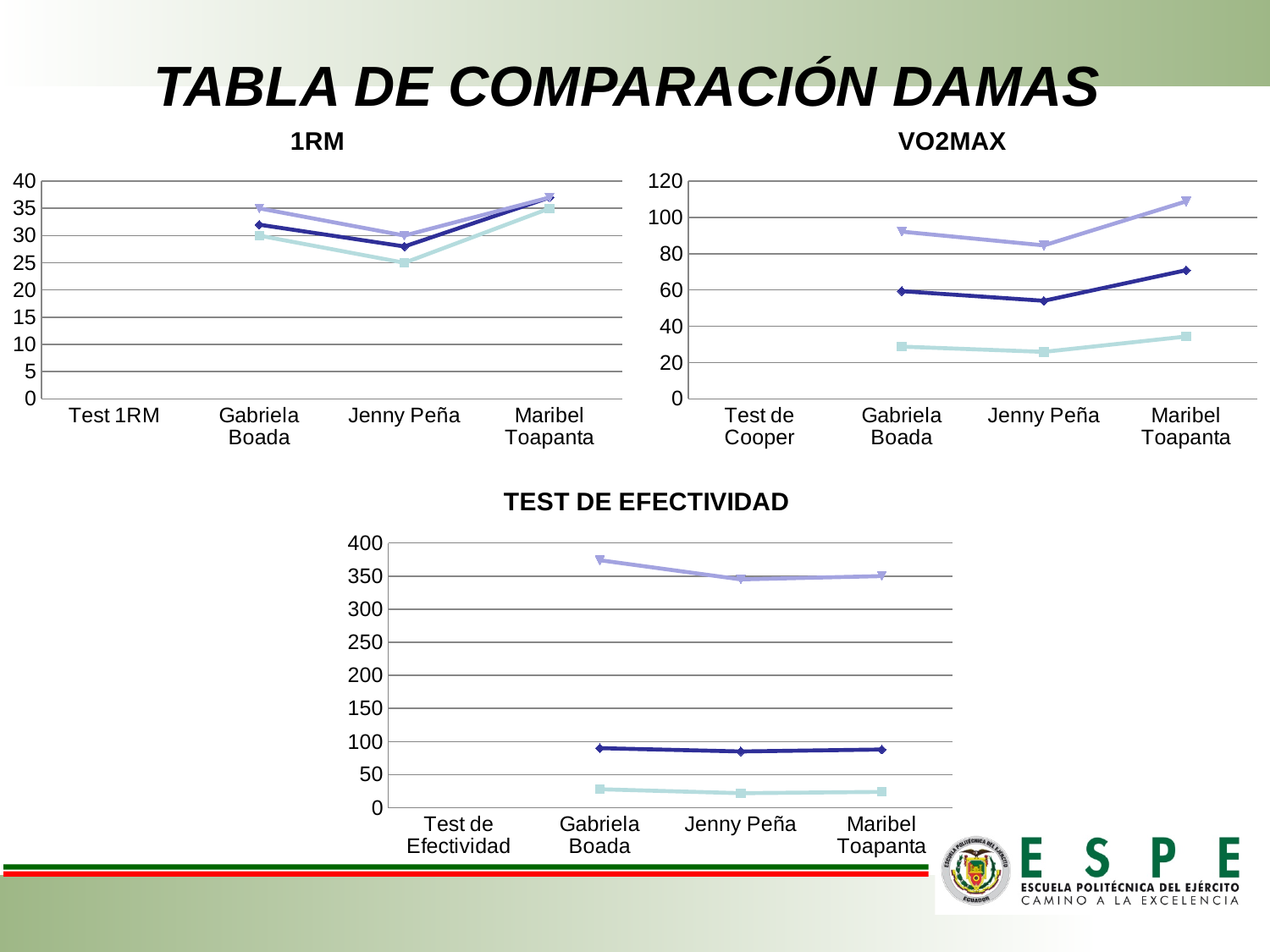
In the VO2MAX chart, does the dark blue line rise or fall from Jenny Peña to Maribel Toapanta? rises What kind of chart is the 1RM chart? line chart How many charts are shown on the slide? 3 In the TEST DE EFECTIVIDAD chart, for Gabriela Boada, which line has the larger value: the light purple line or the dark blue line? the light purple line In the 1RM chart, is the value of the light cyan line for Jenny Peña greater or less than 30? less In the VO2MAX chart, is the value of the light cyan line for Jenny Peña greater or less than 40? less In the VO2MAX chart, is the value of the dark blue line for Maribel Toapanta greater or less than 60? greater In the 1RM chart, which person has the highest value on the light purple line? Maribel Toapanta In the 1RM chart, which person has the lowest value on the dark blue line? Jenny Peña How many categories are on the x axis of the VO2MAX chart? 4